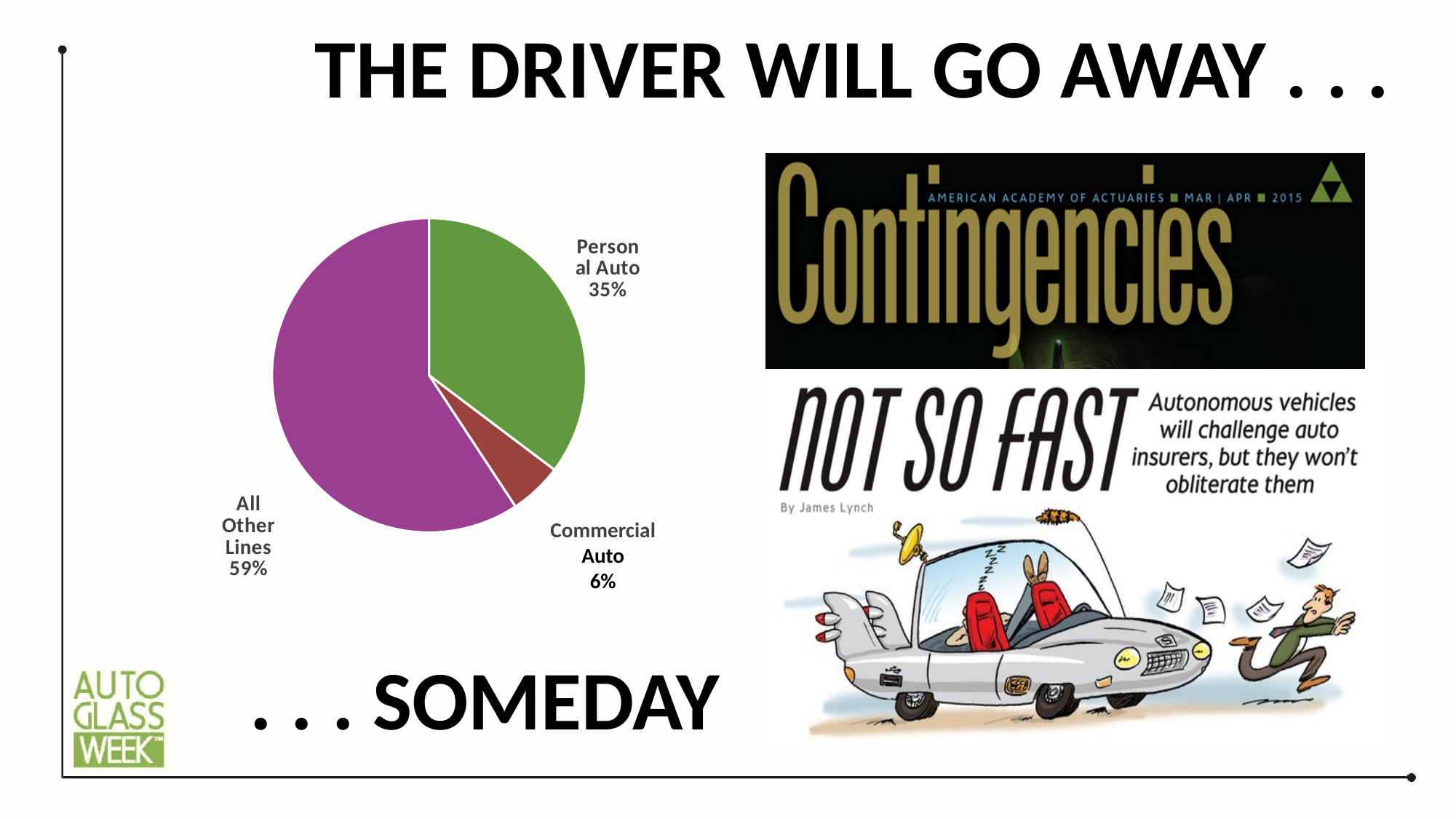
What share of the pie is Personal Auto? 35% Which is larger, Personal Auto or Commercial Auto? Personal Auto What share of the pie is All Other Lines? 59% What kind of chart is shown on the slide? pie chart What is the difference in percentage points between Personal Auto and Commercial Auto? 29 What is the difference in percentage points between All Other Lines and Personal Auto? 24 Which slice of the pie is the largest? All Other Lines Which slice of the pie is the smallest? Commercial Auto What share of the pie is Commercial Auto? 6% How many slices does the pie chart have? 3 What colour is the Personal Auto slice? green What colour is the All Other Lines slice? purple